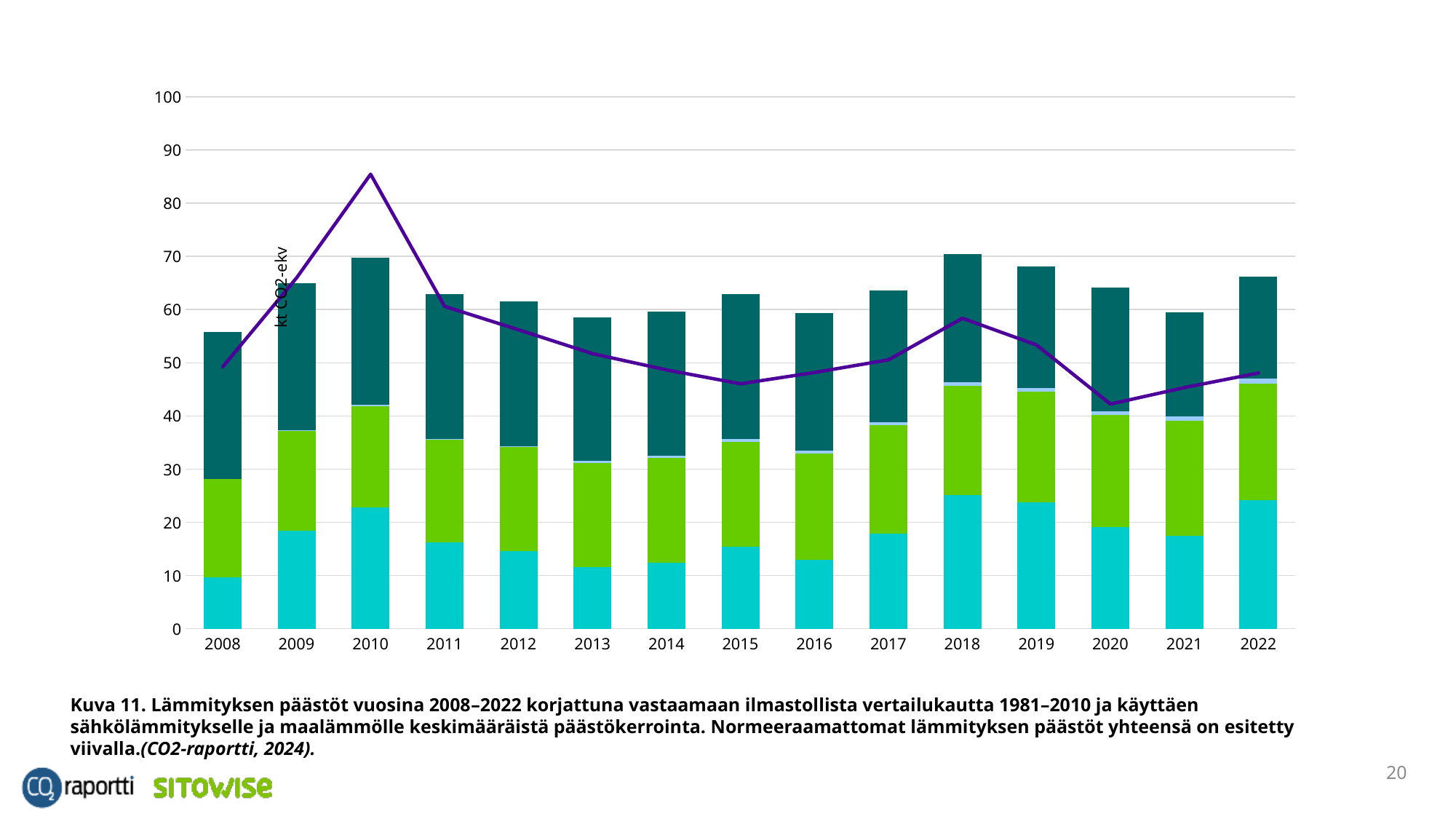
Is the line value for 2020 greater or less than 50? less Which is larger, the total stacked bar for 2010 or for 2008? 2010 Which year has the lowest total stacked bar? 2008 What kind of chart is shown on the slide? Stacked bar chart with a line What is the first year shown on the x axis? 2008 In which year does the line reach its highest value? 2010 What is the label of the vertical axis? kt CO2-ekv Is the total stacked bar for 2008 greater or less than 60? less Is the line value for 2010 greater or less than 80? greater Does the line rise or fall from 2010 to 2015? fall How many years are shown on the x axis of the chart? 15 In which year does the line reach its lowest value? 2020